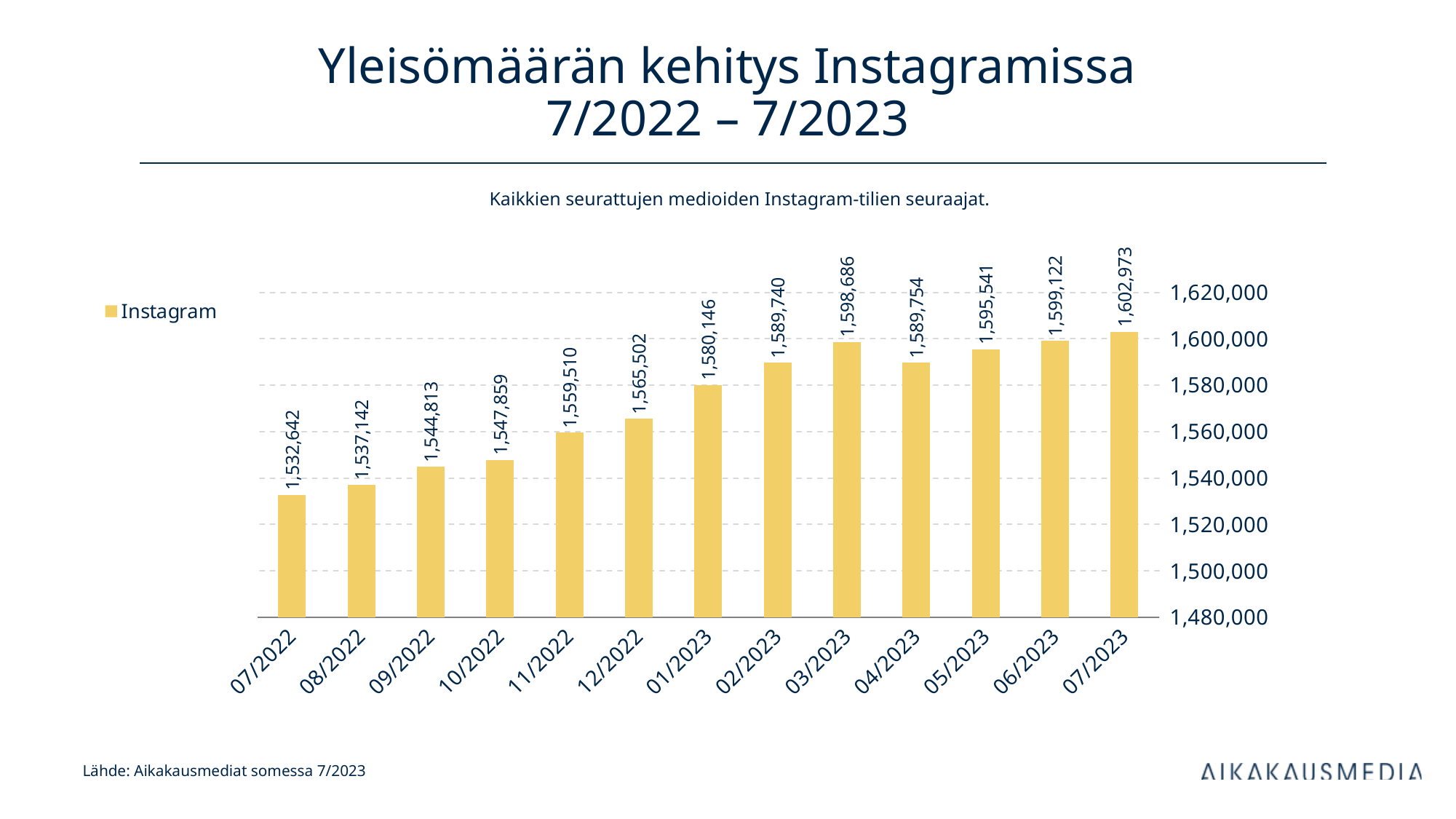
What is the difference between the values for 03/2023 and 04/2023? 8,932 Which month has the lowest value? 07/2022 What is the difference between the values for 07/2023 and 07/2022? 70,331 What series name does the legend show? Instagram What kind of chart is shown on the slide? bar chart Which month has the highest value? 07/2023 How many months are shown on the x axis? 13 Is the value for 09/2022 greater or less than 1,540,000? greater What is the value for 03/2023? 1,598,686 Which is larger, the value for 03/2023 or the value for 04/2023? 03/2023 What is the value for 07/2022? 1,532,642 What is the value for 12/2022? 1,565,502